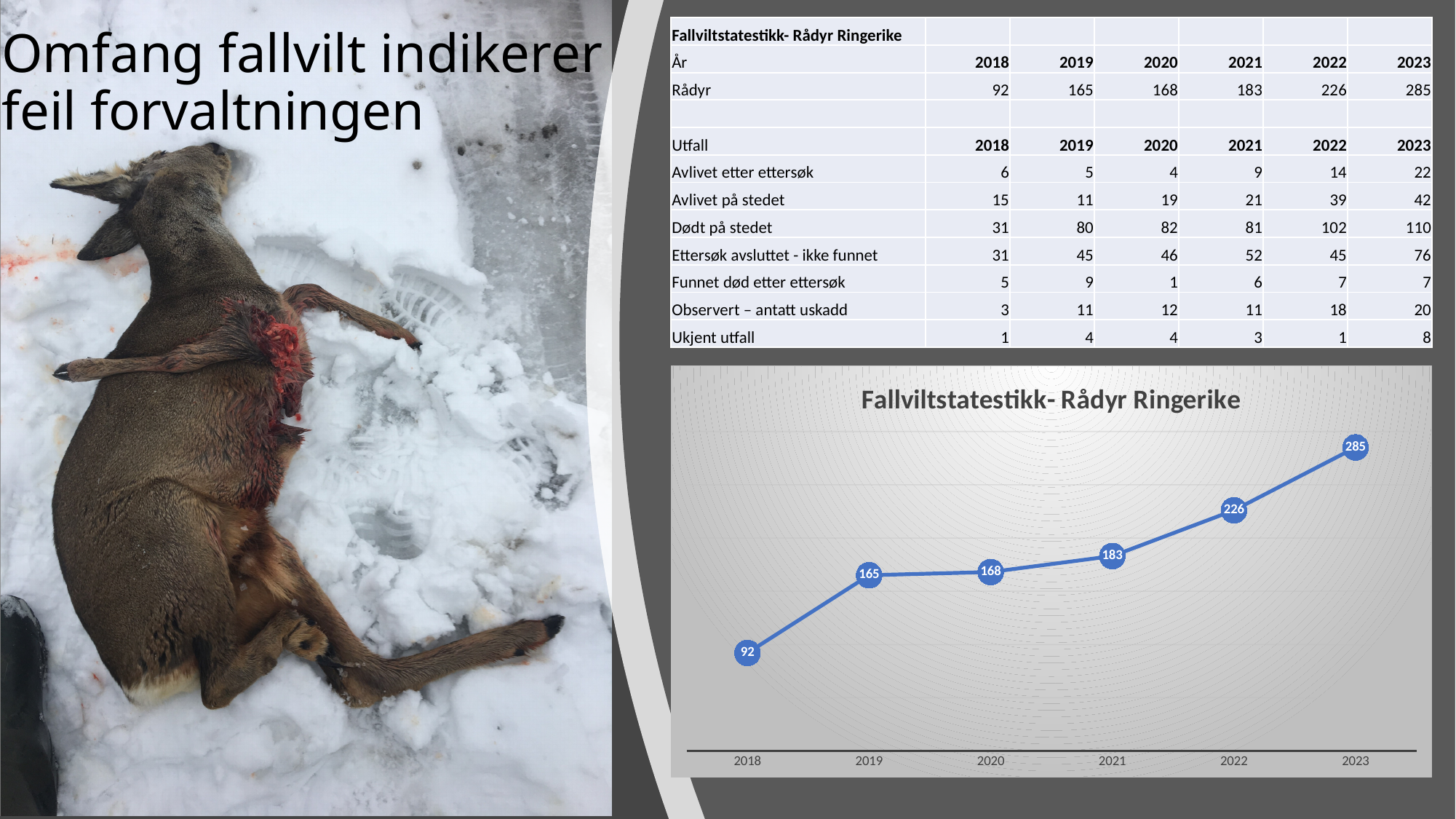
Which is larger in the chart, the value for 2020 or the value for 2022? 2022 What is the value for 2021 in the chart? 183 Which year has the highest value in the chart? 2023 What is the difference between the values for 2019 and 2018 in the chart? 73 What is the value for 2023 in the chart? 285 What is the difference between the values for 2023 and 2022 in the chart? 59 What is the title of the chart? Fallviltstatestikk- Rådyr Ringerike What is the value for 2018 in the chart? 92 Do the values in the chart rise or fall from 2018 to 2023? rise What kind of chart is shown on the slide? line chart How many data points are plotted in the chart? 6 Which year has the lowest value in the chart? 2018